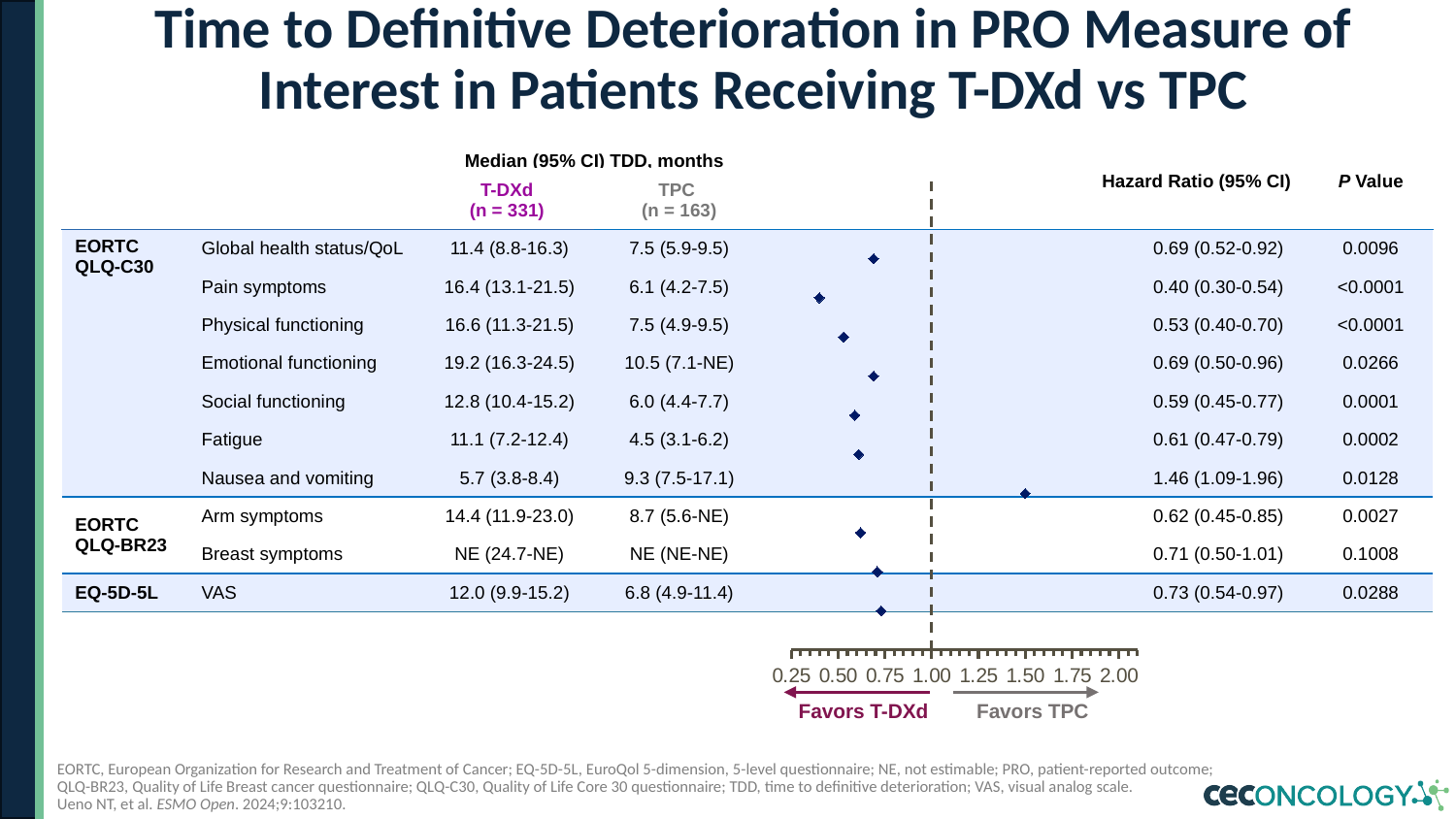
What is the number of patients (n) in the T-DXd group shown in the column header? 331 How many PRO measures (rows) are plotted in the forest plot? 10 Is the hazard ratio point for Nausea and vomiting greater or less than 1.00 on the forest plot axis? greater Which has the larger hazard ratio: Physical functioning or Social functioning? Social functioning Which PRO measure has the lowest hazard ratio in the forest plot? Pain symptoms What is the difference between the T-DXd and TPC median TDD for Pain symptoms (16.4 vs 6.1 months)? 10.3 months What kind of chart is shown on the slide? Forest plot What is the P value for Breast symptoms? 0.1008 What is the hazard ratio (95% CI) for Pain symptoms? 0.40 (0.30-0.54) Which side of the forest plot axis is labelled 'Favors T-DXd'? Left What is the median TDD in months for T-DXd for Emotional functioning? 19.2 (16.3-24.5) Which PRO measure has the highest hazard ratio in the forest plot? Nausea and vomiting